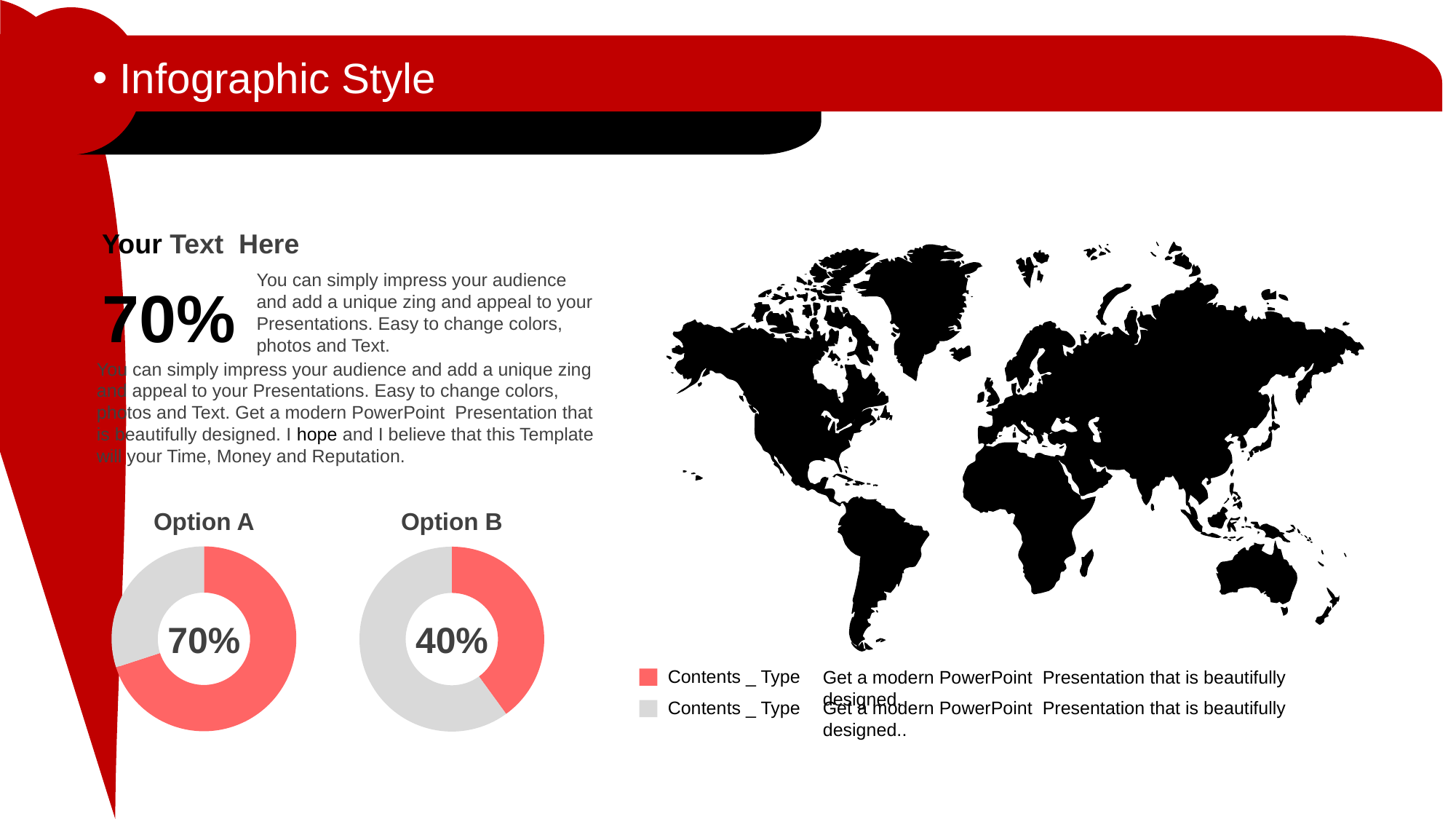
In the Option B doughnut chart, is the red slice larger or smaller than the grey slice? Smaller What is the difference between the percentage shown for Option A and the percentage shown for Option B? 30% What is the title of the doughnut chart on the left? Option A What colour is the slice that represents the percentage shown in the centre of each doughnut chart? Red What value is shown in the centre of the Option A doughnut chart? 70% Which option has the higher percentage, Option A or Option B? Option A How many entries does the legend below the world map list? 2 In the Option A doughnut chart, is the red slice larger or smaller than the grey slice? Larger What kind of chart is used for Option A and Option B? Doughnut chart Which of the two doughnut charts shows the lowest percentage? Option B How many doughnut charts are shown on the slide? 2 What value is shown in the centre of the Option B doughnut chart? 40%